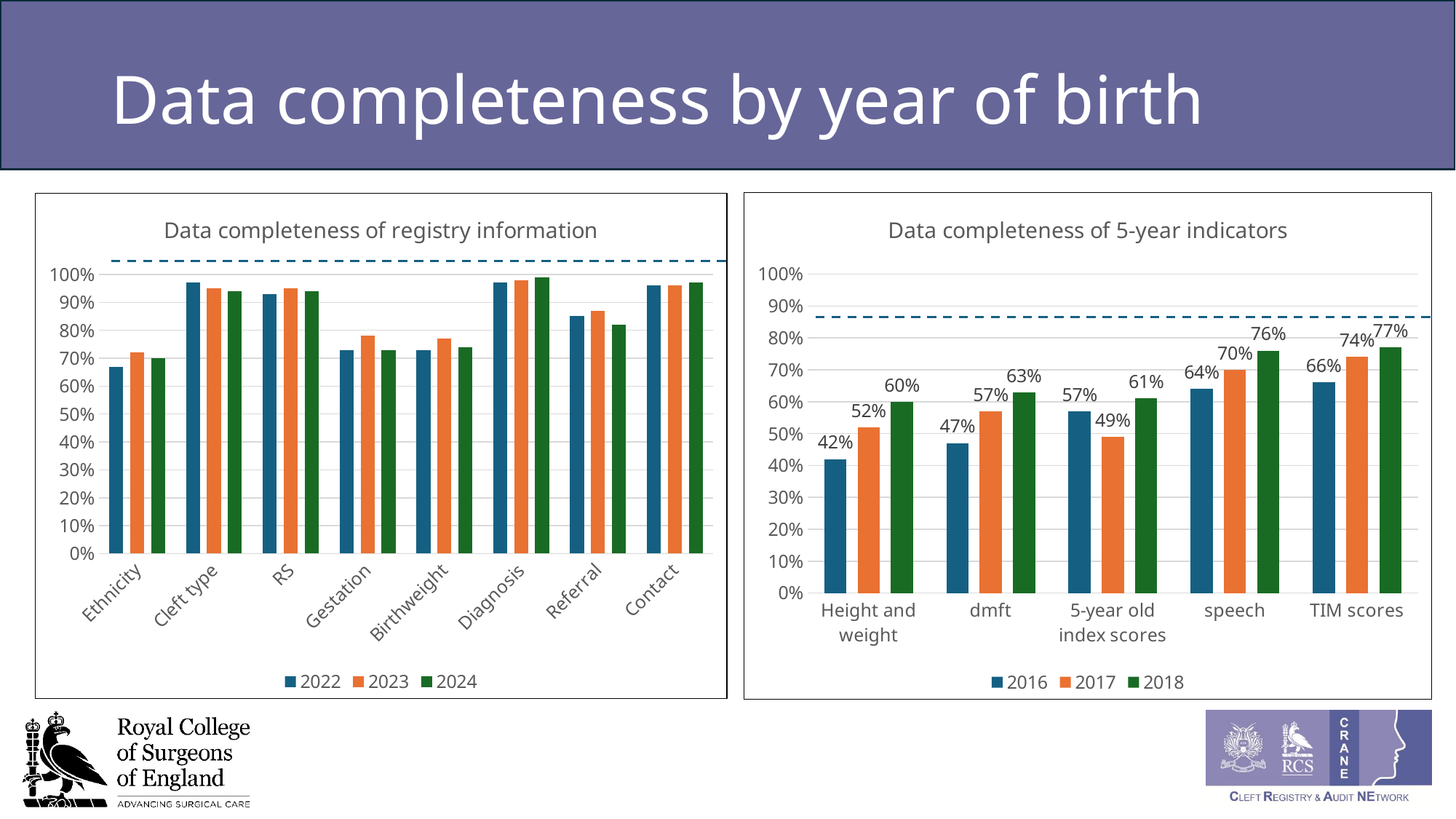
In the 'Data completeness of 5-year indicators' chart, what is the difference between the 2018 and 2016 values for dmft? 16% In the 'Data completeness of registry information' chart, is the value for Referral in 2023 greater or less than 80%? greater In the 'Data completeness of 5-year indicators' chart, what is the value for speech in 2018? 76% What kind of chart is the 'Data completeness of registry information' chart? Bar chart How many series does the legend of the 'Data completeness of 5-year indicators' chart list? 3 In the 'Data completeness of 5-year indicators' chart, what is the value for 5-year old index scores in 2017? 49% In the 'Data completeness of 5-year indicators' chart, which category has the lowest value for 2016? Height and weight In the 'Data completeness of 5-year indicators' chart, which category has the highest value for 2018? TIM scores In the 'Data completeness of registry information' chart, is the value for Ethnicity in 2022 greater or less than 70%? less In the 'Data completeness of 5-year indicators' chart, what is the value for Height and weight in 2016? 42% In the 'Data completeness of 5-year indicators' chart, which is larger for 5-year old index scores: the 2016 value or the 2017 value? 2016 How many categories are shown on the x axis of the 'Data completeness of registry information' chart? 8